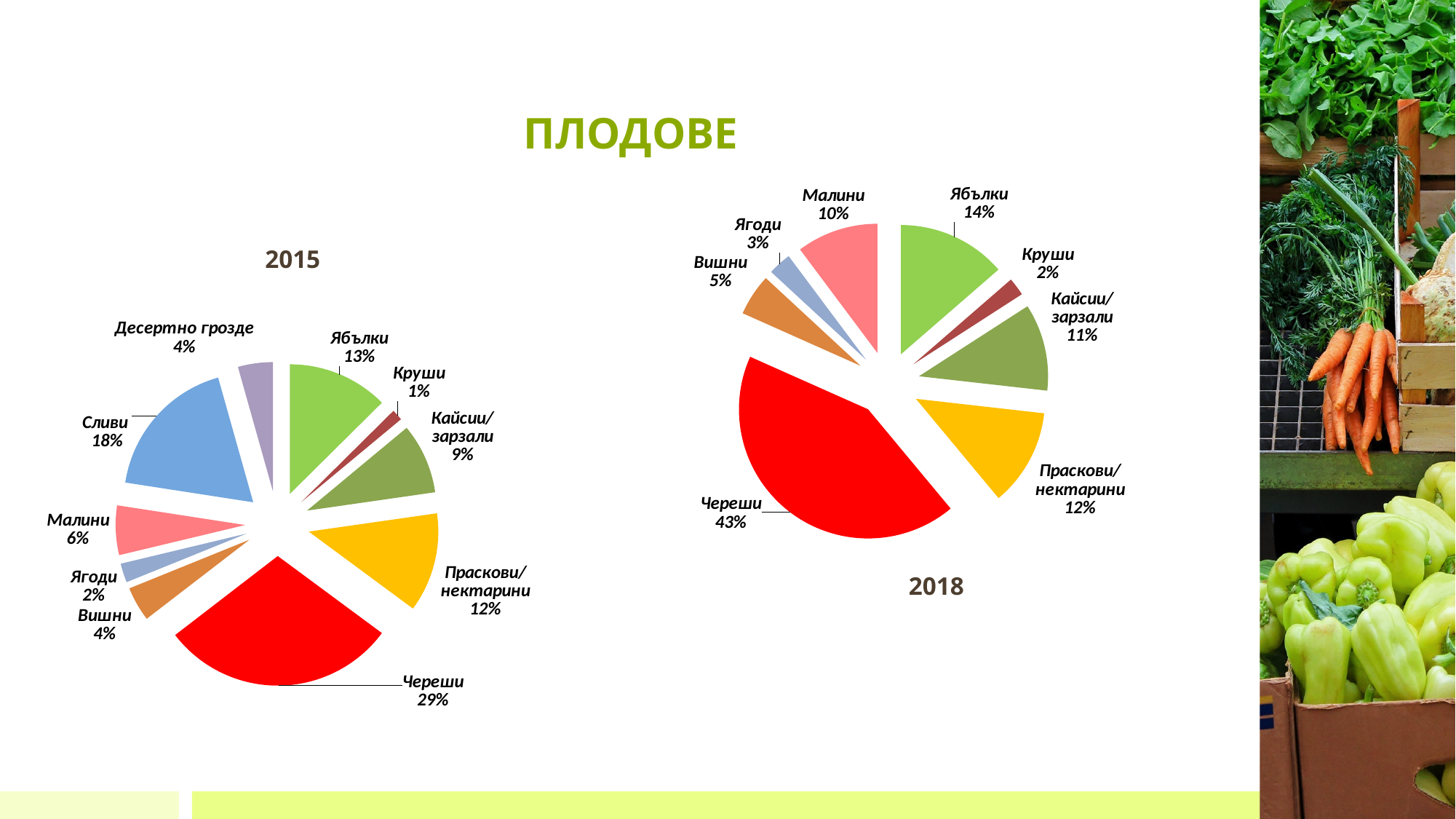
How many categories are shown in the 2015 pie chart? 10 In the 2015 pie chart, which category has the largest share? Череши In the 2015 pie chart, what share do Череши have? 29% How many categories are shown in the 2018 pie chart? 8 What type of chart is used for the 2015 data? Pie chart In the 2015 pie chart, what is the share for Сливи? 18% In the 2018 pie chart, what share do Череши have? 43% In the 2015 pie chart, which category has the smallest share? Круши In the 2018 pie chart, which is larger: Ябълки or Кайсии/зарзали? Ябълки What is the difference between the share of Череши in 2018 and in 2015? 14% In the 2018 pie chart, which category has the smallest share? Круши In the 2018 pie chart, what is the share for Малини? 10%